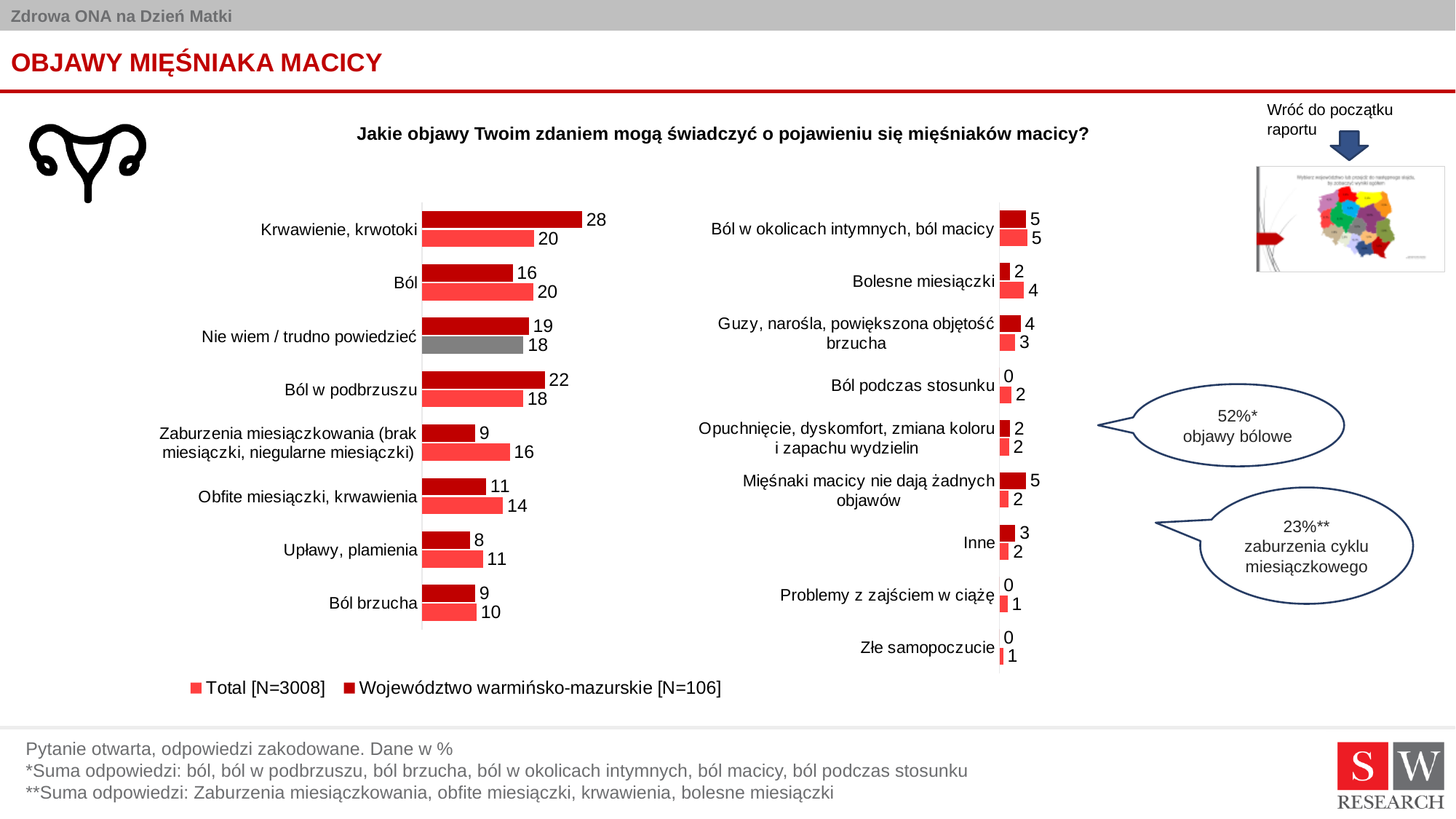
In the left chart, which category has the highest Województwo warmińsko-mazurskie [N=106] value? Krwawienie, krwotoki What type of chart is used on this slide? Bar chart In the left chart, which is larger for Ból: the Total [N=3008] value or the Województwo warmińsko-mazurskie [N=106] value? Total [N=3008] In the right chart, what is the Total [N=3008] value for Bolesne miesiączki? 4 How many categories are shown in the right chart? 9 In the right chart, what is the Województwo warmińsko-mazurskie [N=106] value for Mięśniaki macicy nie dają żadnych objawów? 5 In the left chart, what is the difference between the Województwo warmińsko-mazurskie [N=106] and Total [N=3008] values for Ból w podbrzuszu? 4 In the left chart, what is the Total [N=3008] value for Zaburzenia miesiączkowania (brak miesiączki, niegularne miesiączki)? 16 In the left chart, what is the Województwo warmińsko-mazurskie [N=106] value for Krwawienie, krwotoki? 28 How many series does the legend list? 2 In the left chart, what is the Total [N=3008] value for Krwawienie, krwotoki? 20 In the left chart, which category has the lowest Total [N=3008] value? Ból brzucha